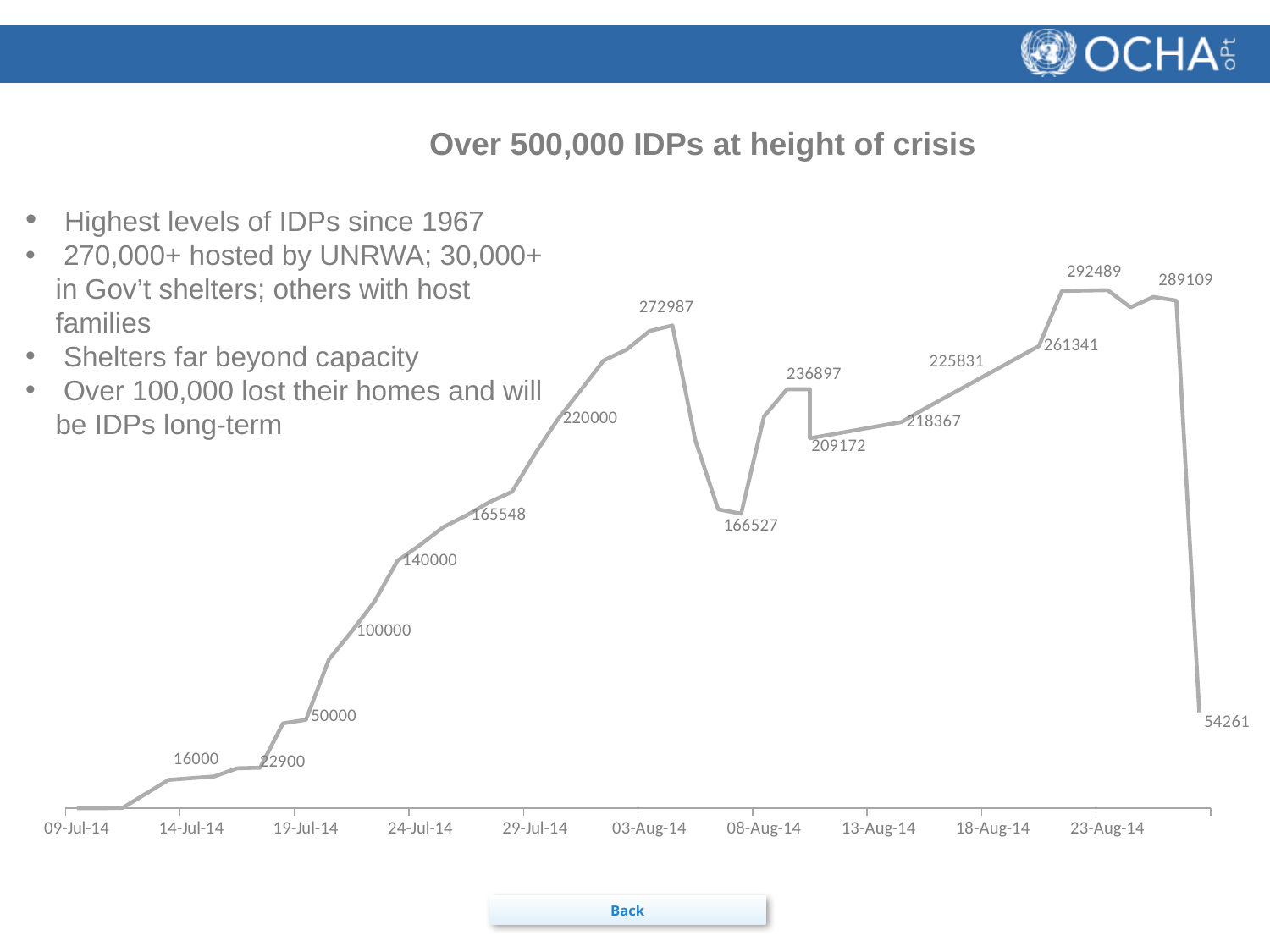
What kind of chart is shown on the slide? line chart What is the difference between the labeled values 292489 and 289109? 3380 How many date labels are shown on the x axis? 10 Which labeled value is larger, 236897 or 209172? 236897 What is the difference between the labeled peak of 272987 and the following labeled low of 166527? 106460 What is the highest value labeled on the line chart? 292489 What is the title of the slide's chart? Over 500,000 IDPs at height of crisis How many data labels are printed on the line chart? 17 What is the last data label shown at the right end of the line? 54261 What is the value of the first peak labeled on the chart, just before the line drops sharply in early August? 272987 What is the lowest value labeled on the line chart? 16000 Does the line rise or fall between 09-Jul-14 and 03-Aug-14? rise